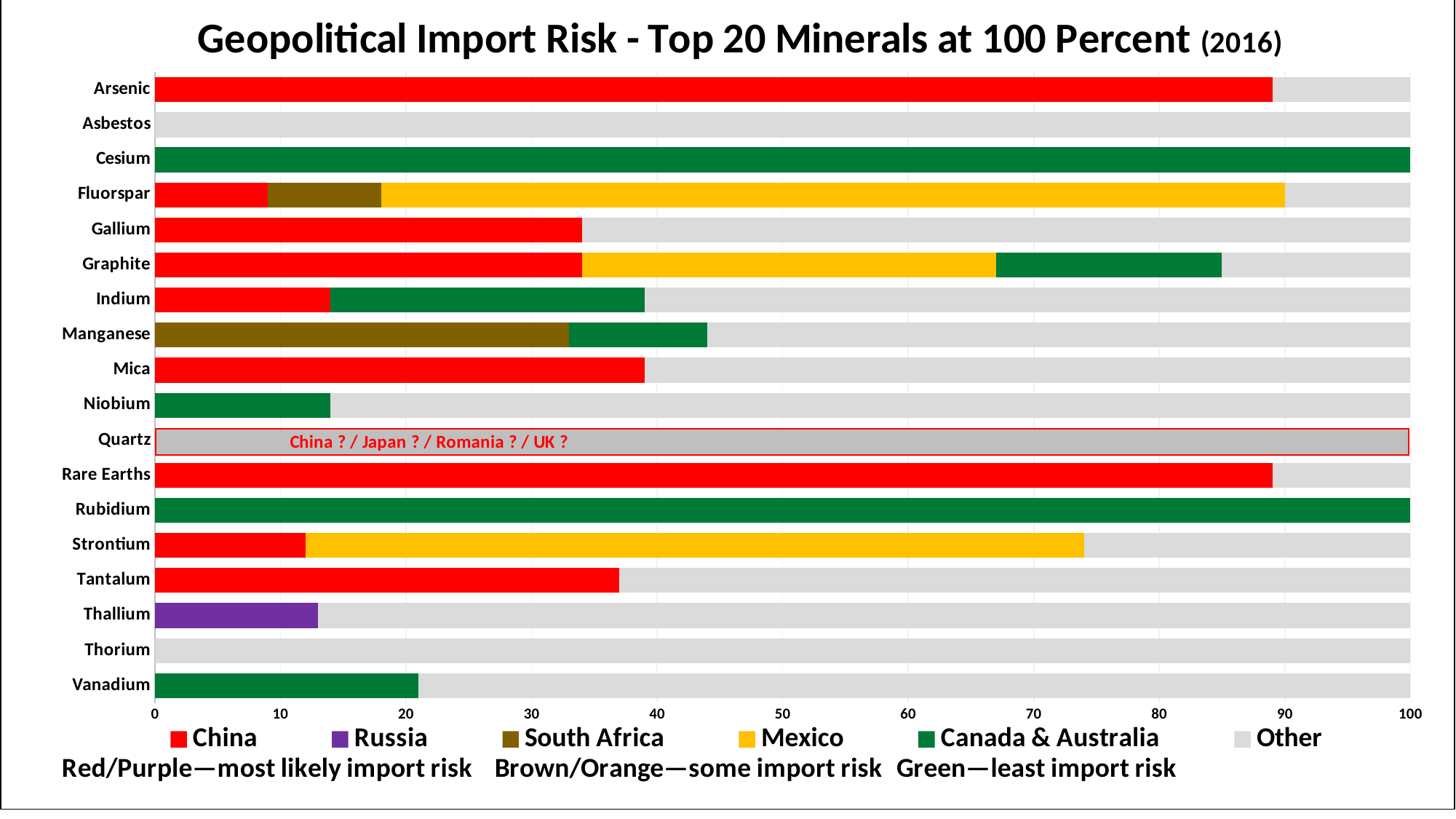
Is the China value for Gallium greater or less than 30? greater Which is larger, the China value for Tantalum or the China value for Strontium? Tantalum Is the China value for Arsenic greater or less than 80? greater How many minerals are listed on the vertical axis? 18 Which country does the purple colour represent in the legend? Russia Is the Canada & Australia value for Vanadium greater or less than 30? less What kind of chart is shown on the slide? Stacked bar chart How many series does the legend list? 6 What year is shown in the chart title? 2016 What is the value of the Canada & Australia segment for Rubidium? 100 What is the value of the Canada & Australia segment for Cesium? 100